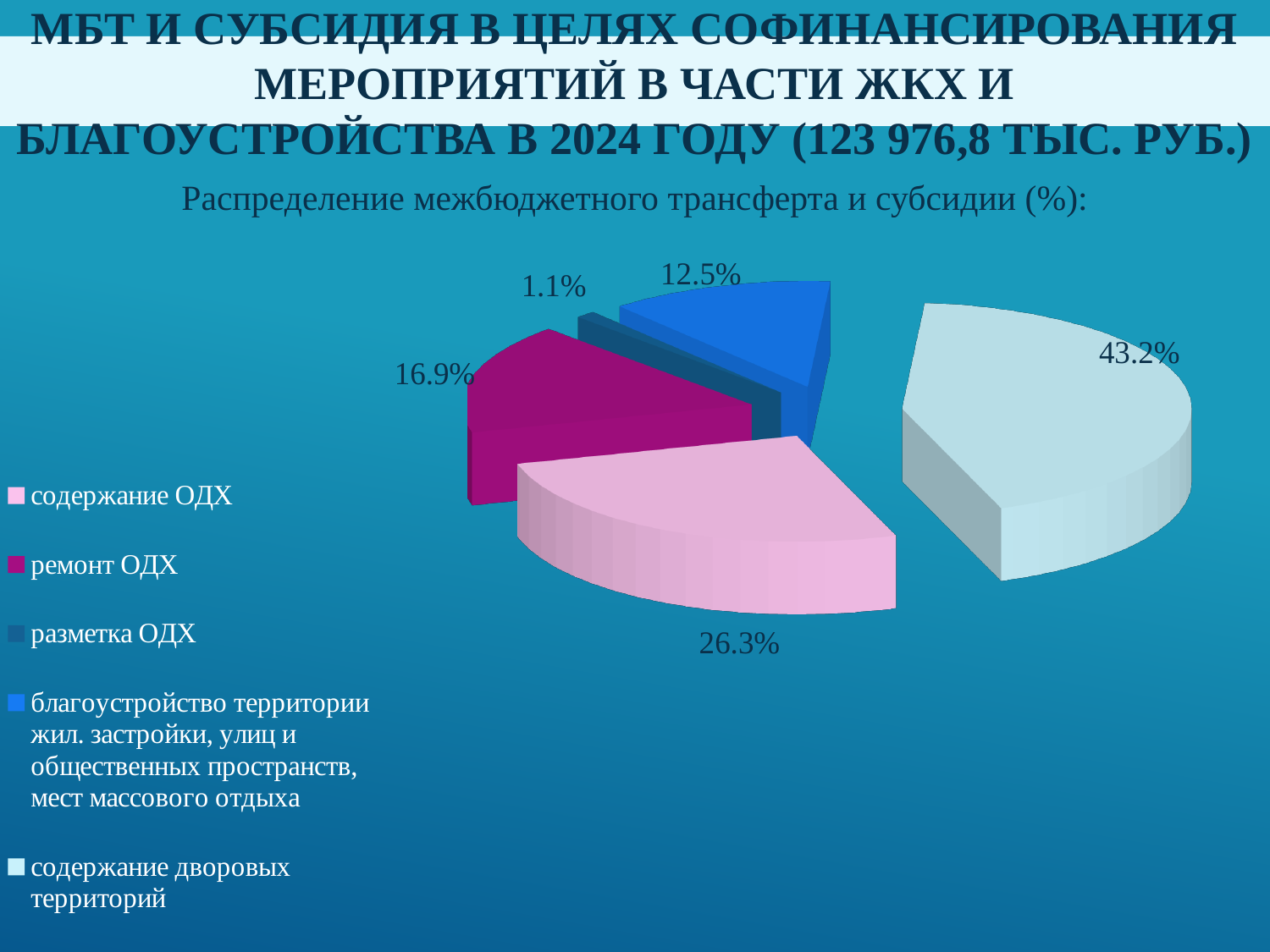
Which is larger: the slice for "ремонт ОДХ" or the slice for "благоустройство территории жил. застройки, улиц и общественных пространств, мест массового отдыха"? ремонт ОДХ What share of the pie does "содержание дворовых территорий" have? 43.2% What share of the pie does "содержание ОДХ" have? 26.3% What share of the pie does "благоустройство территории жил. застройки, улиц и общественных пространств, мест массового отдыха" have? 12.5% What is the subtitle shown above the pie chart? Распределение межбюджетного трансферта и субсидии (%): What kind of chart is shown on the slide? pie chart How many slices does the pie chart have? 5 What share of the pie does "ремонт ОДХ" have? 16.9% What is the difference in percentage points between "содержание ОДХ" and "ремонт ОДХ"? 9.4 Which category has the largest slice of the pie? содержание дворовых территорий What share of the pie does "разметка ОДХ" have? 1.1% Which category has the smallest slice of the pie? разметка ОДХ